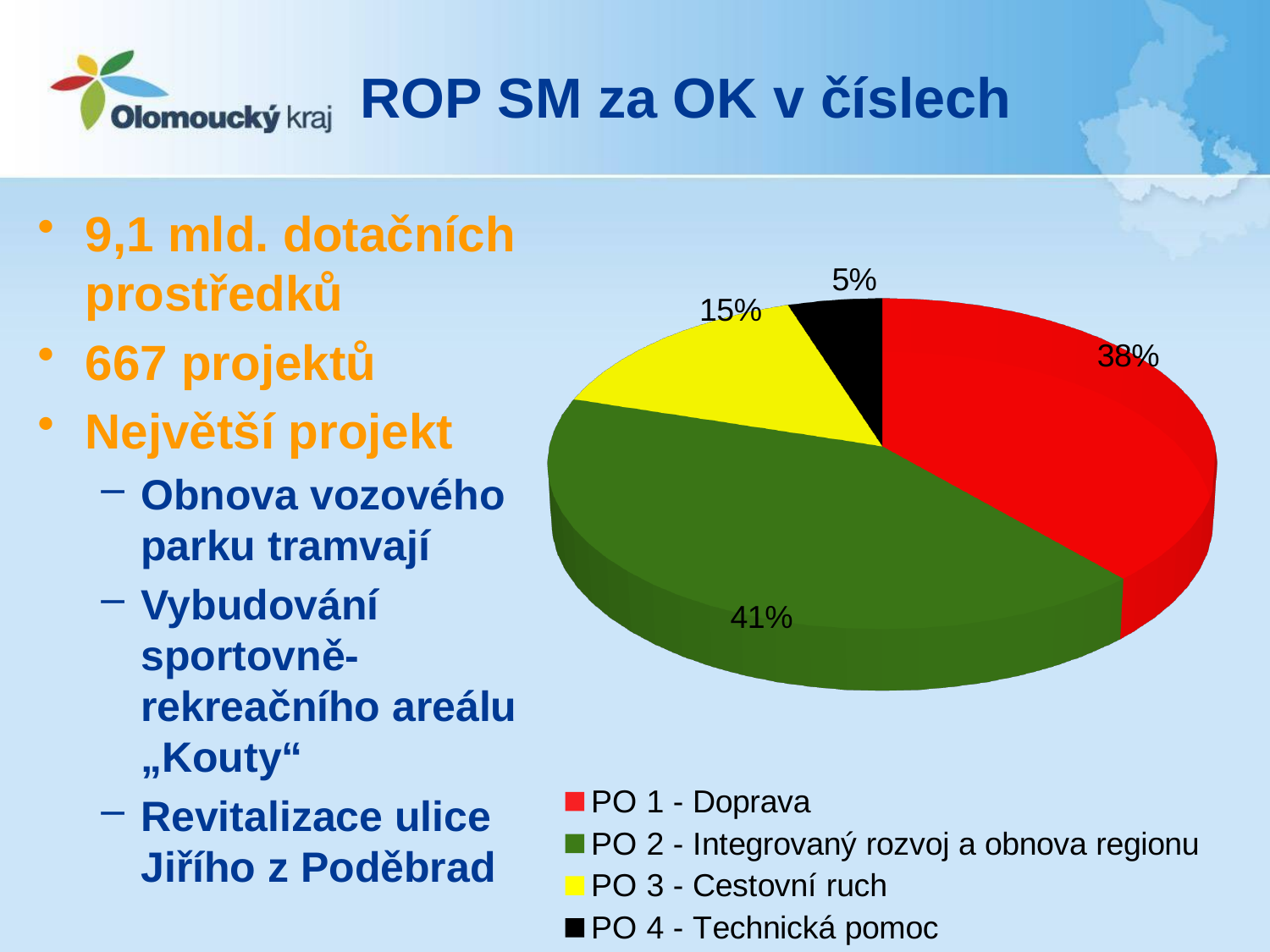
How many slices does the pie chart have? 4 Which category has the largest slice of the pie? PO 2 - Integrovaný rozvoj a obnova regionu Which category has the smallest slice of the pie? PO 4 - Technická pomoc What kind of chart is shown on the slide? pie chart Which is larger, the share for PO 3 - Cestovní ruch or the share for PO 4 - Technická pomoc? PO 3 - Cestovní ruch What share of the pie does PO 3 - Cestovní ruch have? 15% What share of the pie does PO 2 - Integrovaný rozvoj a obnova regionu have? 41% What is the difference in percentage points between PO 2 - Integrovaný rozvoj a obnova regionu and PO 1 - Doprava? 3 percentage points How many entries does the legend list? 4 What share of the pie does PO 4 - Technická pomoc have? 5% What colour is the slice for PO 1 - Doprava? red